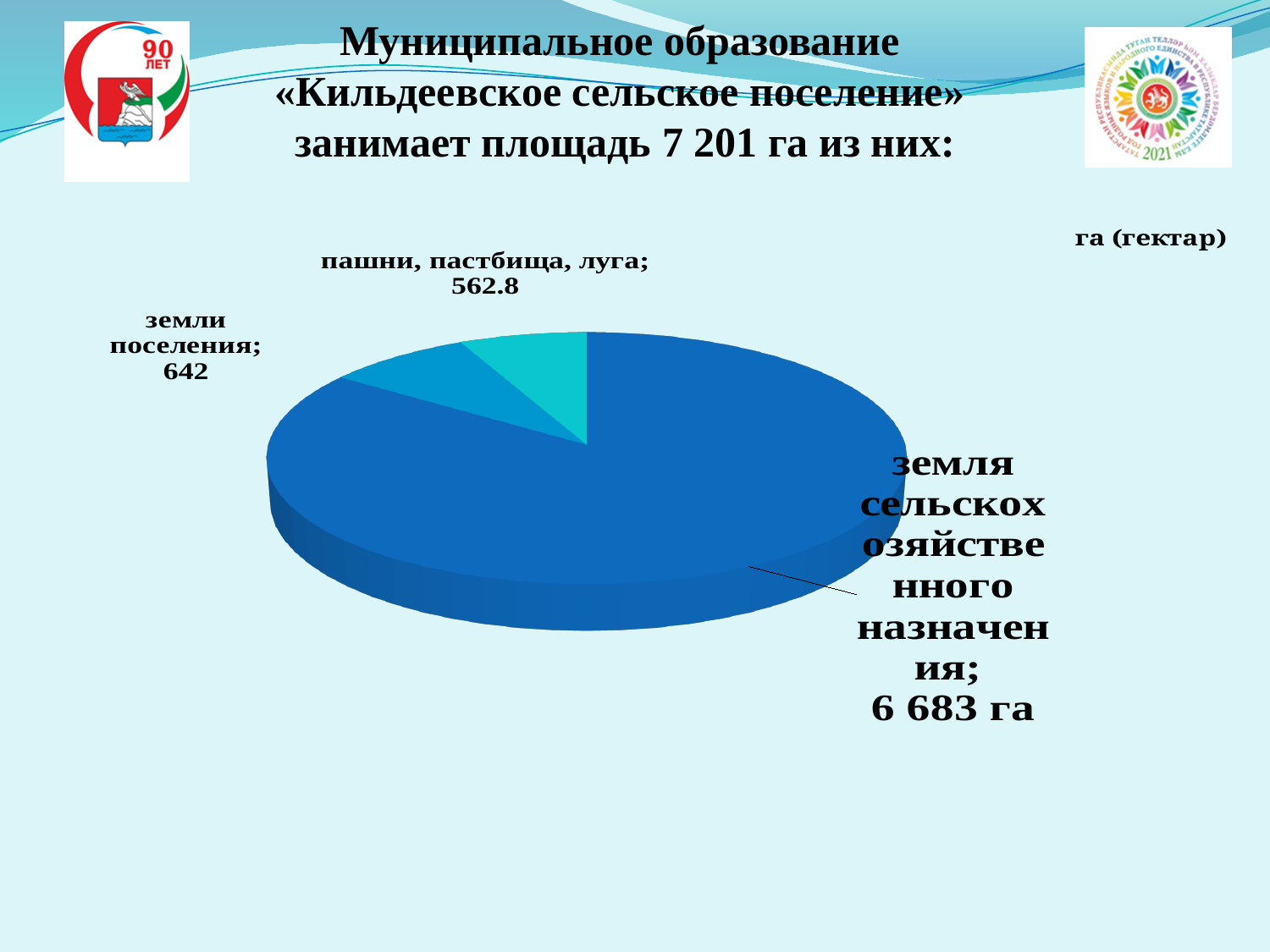
Which category has the smallest slice of the pie? пашни, пастбища, луга What is the difference between the value for "земли поселения" and the value for "пашни, пастбища, луга"? 79.2 What colour is the largest slice of the pie chart? blue Which category has the largest slice of the pie? земля сельскохозяйственного назначения How many slices does the pie chart have? 3 What kind of chart is shown on the slide? pie chart What unit is indicated in the label at the top right of the chart? га (гектар) What is the difference between the value for "земля сельскохозяйственного назначения" and the value for "земли поселения"? 6 041 What value is shown for the slice "пашни, пастбища, луга"? 562.8 What value is shown for the slice "земли поселения"? 642 What value is shown for the slice "земля сельскохозяйственного назначения"? 6 683 га Which is larger: the value for "земли поселения" or the value for "пашни, пастбища, луга"? земли поселения